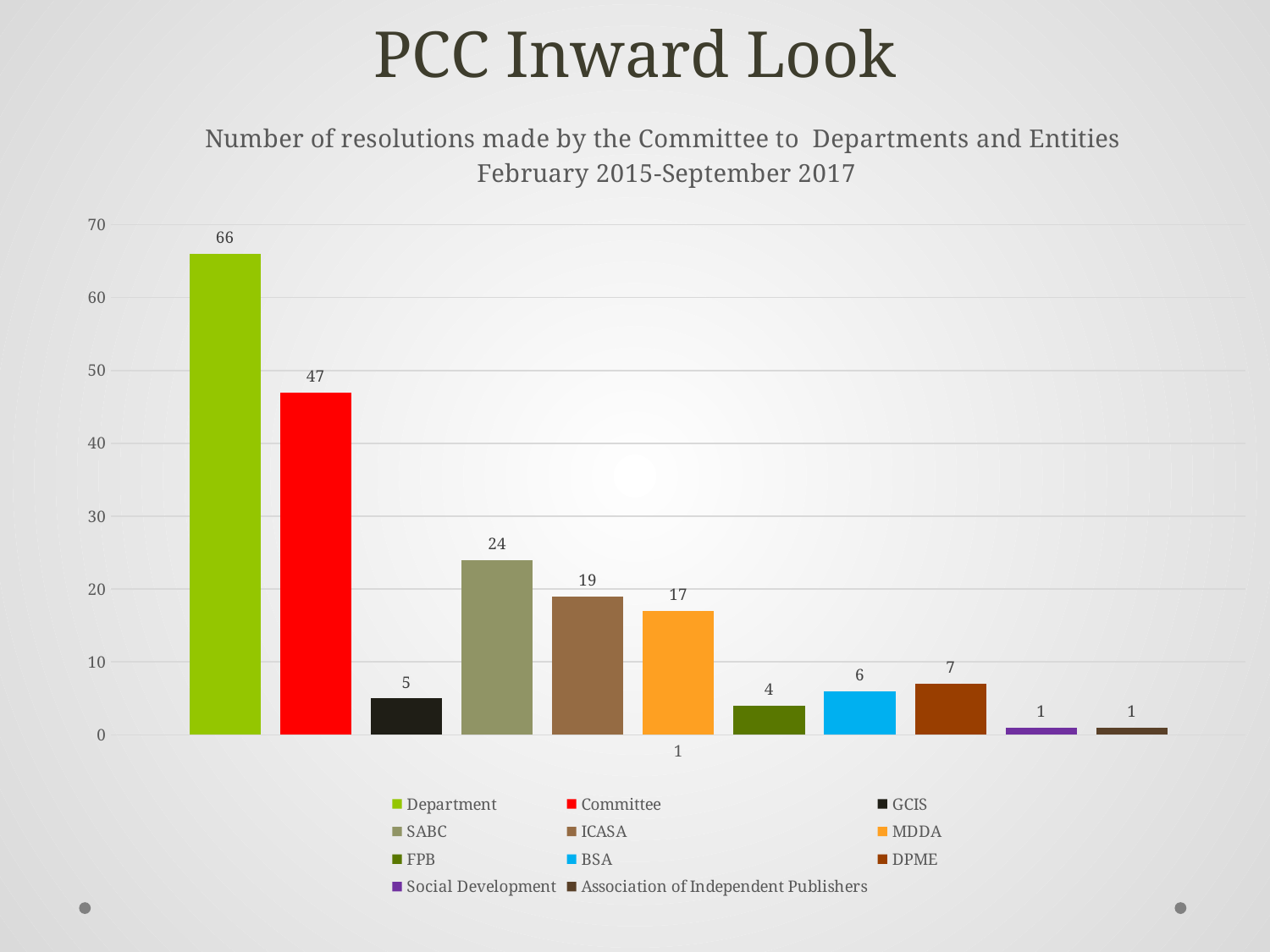
What is the difference between the values for Department and Committee? 19 Which category has the highest value? Department What is the value for Department? 66 What is the value for DPME? 7 What is the difference between the values for ICASA and MDDA? 2 How many entries does the legend list? 11 What kind of chart is shown on the slide? Bar chart What is the value for MDDA? 17 Which is larger, the value for SABC or the value for ICASA? SABC Which is larger, the value for GCIS or the value for BSA? BSA What colour is the bar for Committee? Red What is the value for SABC? 24